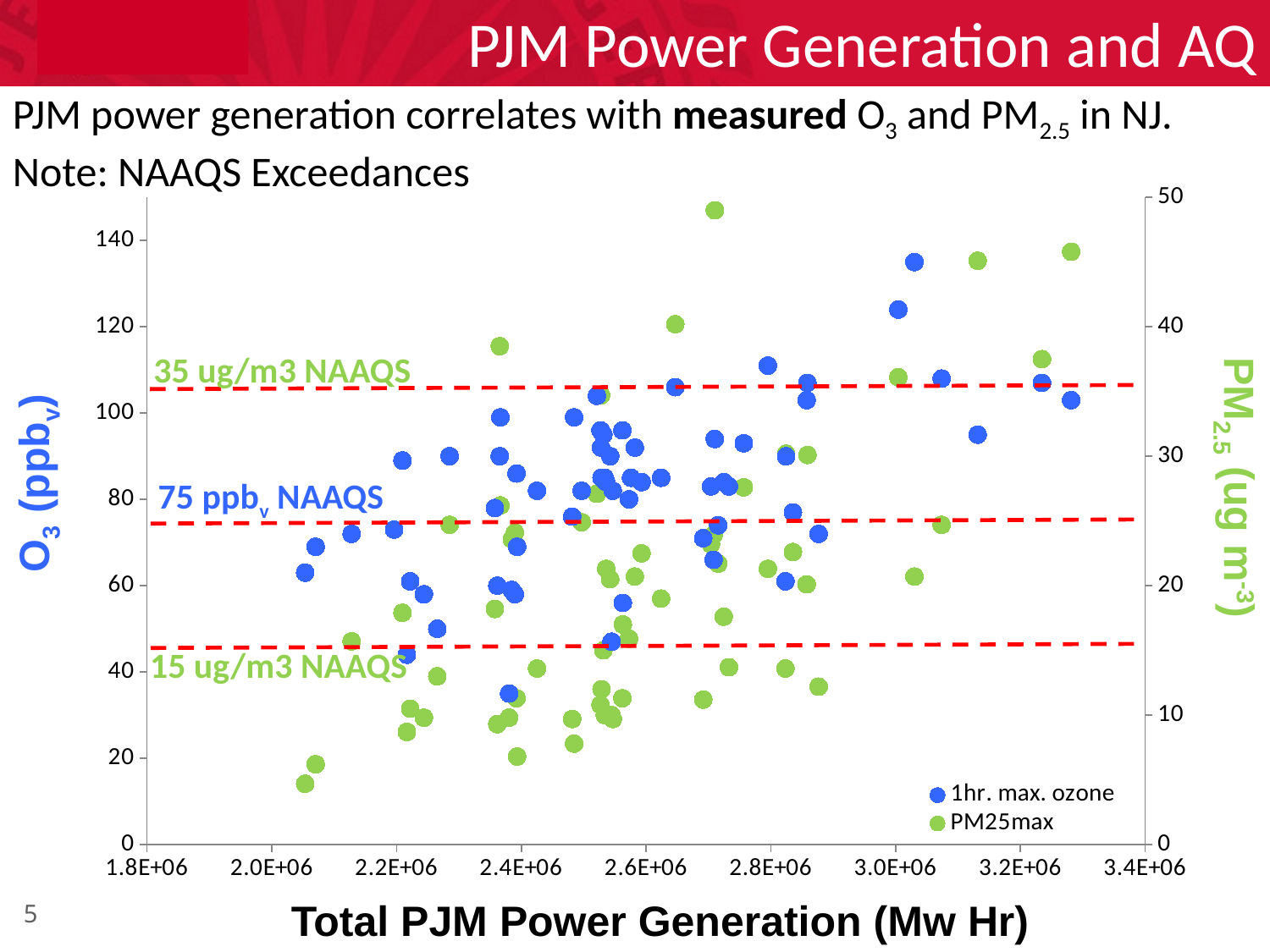
Is the highest 1hr. max. ozone value on the chart greater or less than 120 on the left axis? greater What is the title of the chart's x axis? Total PJM Power Generation (Mw Hr) Is the highest PM25max value on the chart greater or less than 45 on the right axis? greater What ozone level does the dashed NAAQS line for O3 mark on the chart? 75 ppbv Is the lowest PM25max value on the chart greater or less than 10 on the right axis? less Do the 1hr. max. ozone values generally rise or fall as Total PJM Power Generation increases along the x axis? rise What kind of chart is shown on the slide? scatter chart What PM2.5 level does the upper dashed NAAQS line mark on the chart? 35 ug/m3 What are the two series named in the chart's legend? 1hr. max. ozone and PM25max How many series does the chart's legend list? 2 What PM2.5 level does the lower dashed NAAQS line mark on the chart? 15 ug/m3